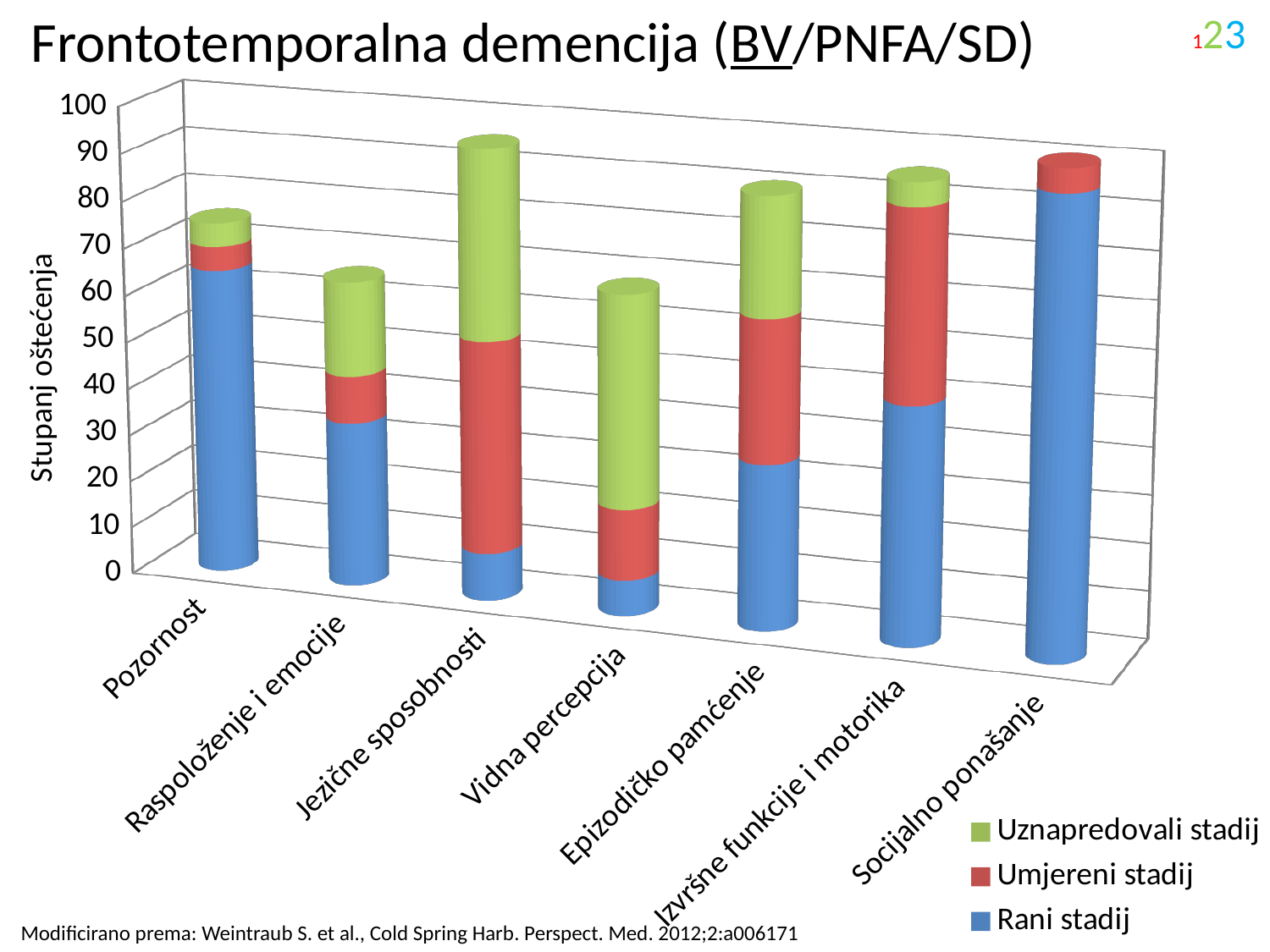
Is the Rani stadij value for Pozornost greater or less than 50? greater Which has the larger Umjereni stadij segment, Izvršne funkcije i motorika or Pozornost? Izvršne funkcije i motorika Is the Rani stadij value for Socijalno ponašanje greater or less than 70? greater Which colour represents the Rani stadij series in the chart? Blue How many categories are shown on the x axis of the chart? 7 What kind of chart is shown on the slide? Stacked bar chart Which category has the largest Rani stadij segment? Socijalno ponašanje What is the title of the vertical axis of the chart? Stupanj oštećenja Is the total stacked value for Raspoloženje i emocije greater or less than 70? less Which has the larger Rani stadij segment, Pozornost or Raspoloženje i emocije? Pozornost How many series does the chart legend list? 3